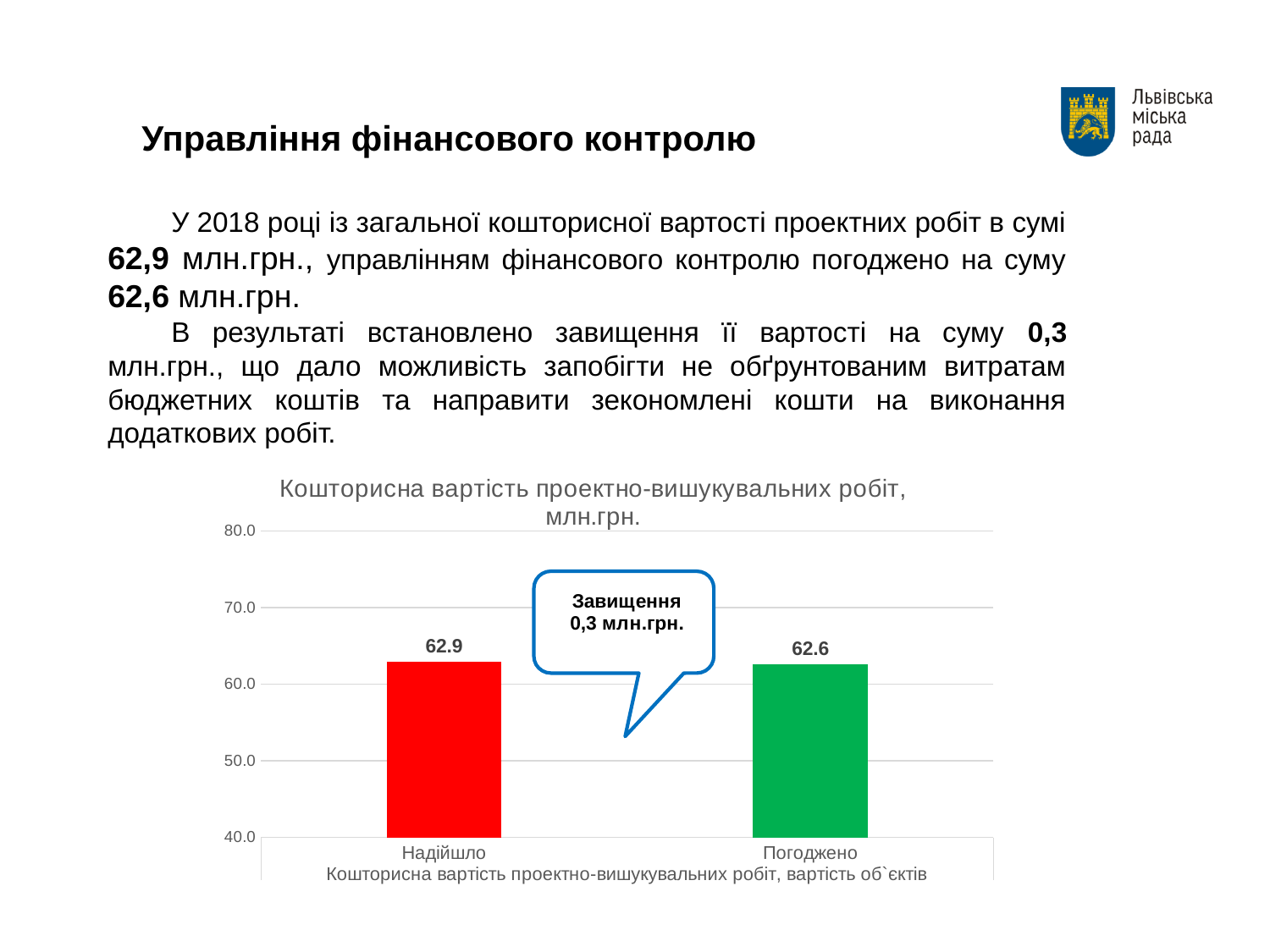
What colour is the bar for Надійшло? red What is the difference between the values for Надійшло and Погоджено? 0.3 Is the value for Погоджено greater or less than 70.0? less Which category has the higher value? Надійшло Which category has the lower value? Погоджено What kind of chart is shown on the slide? bar chart Is the value for Надійшло greater or less than 60.0? greater Do the values rise or fall from Надійшло to Погоджено? fall What is the value for Погоджено? 62.6 What is the title of the chart? Кошторисна вартість проектно-вишукувальних робіт, млн.грн. How many categories are shown on the chart? 2 What is the value for Надійшло? 62.9